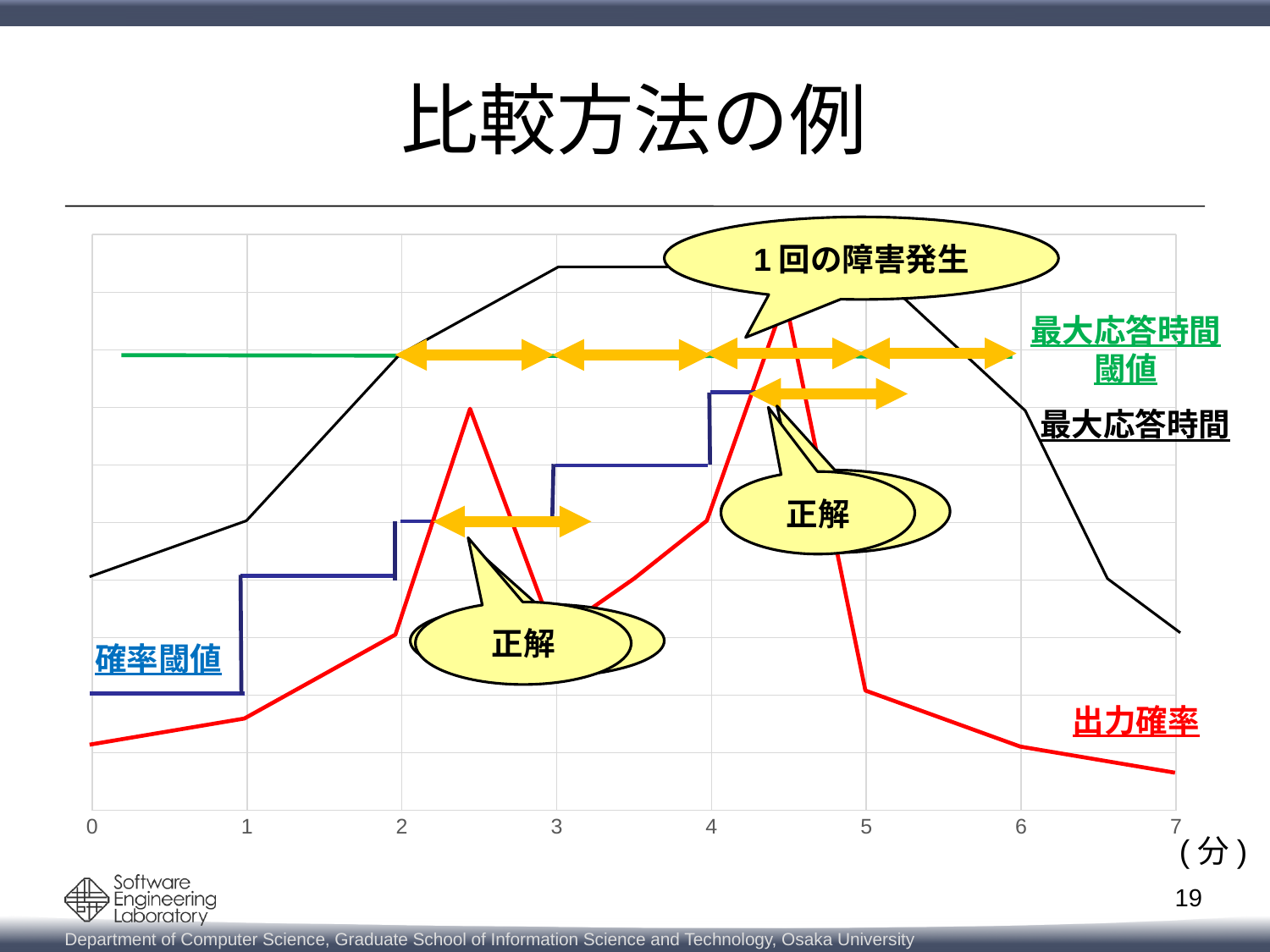
Does the 出力確率 (red) line rise or fall between x = 5 and x = 7? fall How many data series (lines) are plotted on the chart? 4 What is the highest value labelled on the x axis? 7 At x = 2, which is higher: the 最大応答時間 (black) line or the 出力確率 (red) line? 最大応答時間 (black) Which series is drawn as the green line? 最大応答時間閾値 At x = 6, which is higher: the 最大応答時間 (black) line or the 出力確率 (red) line? 最大応答時間 (black) What kind of chart is shown on the slide? line chart At x = 7, which series has the lowest value? 出力確率 What unit is shown for the x axis of the chart? (分) Does the 最大応答時間 (black) line rise or fall between x = 0 and x = 3? rise How many tick labels are shown on the x axis? 8 Does the 確率閾値 (blue) step line rise or fall between x = 0 and x = 4? rise